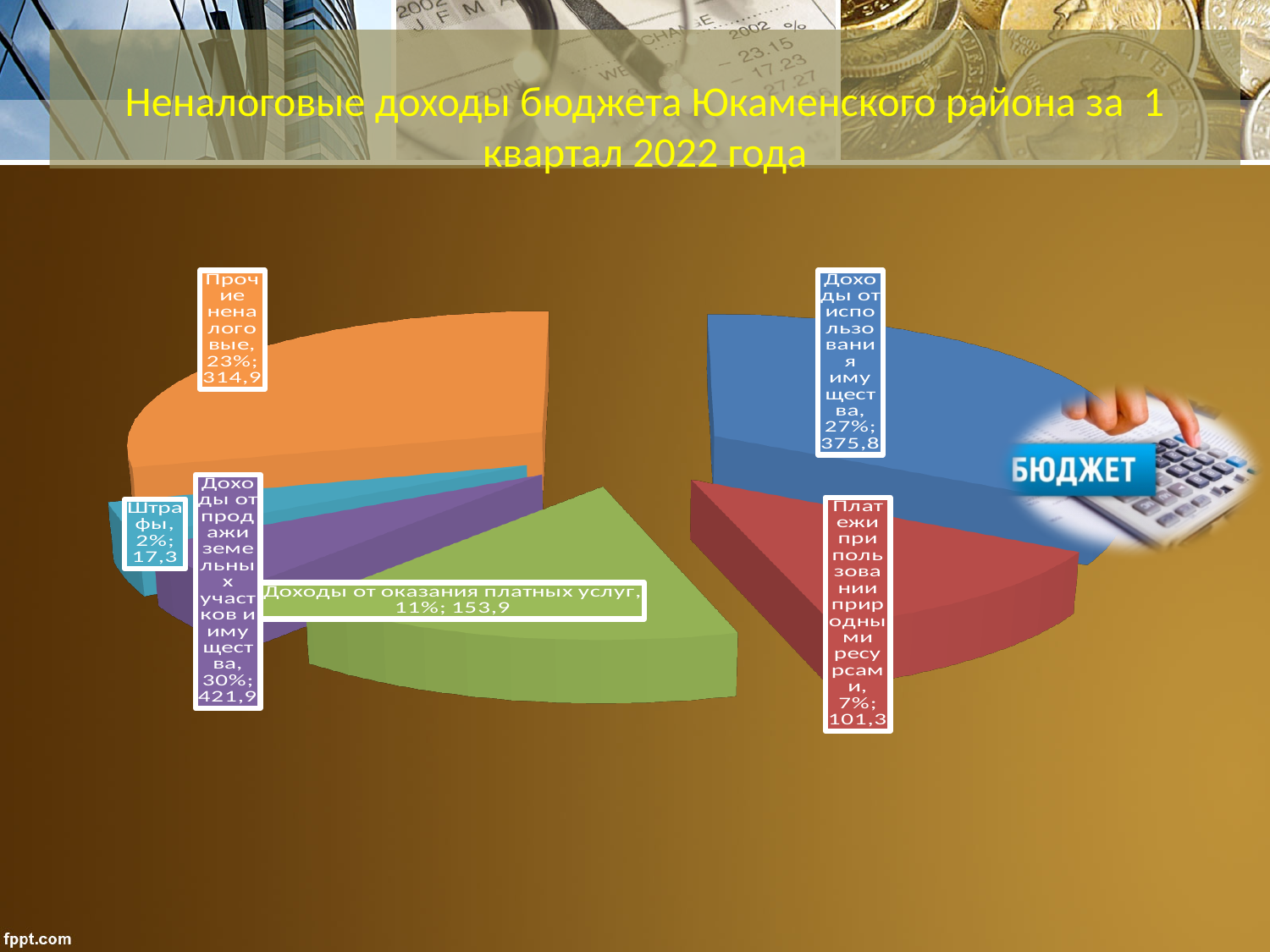
Какое значение указано для категории «Доходы от продажи земельных участков и имущества»? 421,9 На сколько значение «Прочие неналоговые» больше значения «Платежи при пользовании природными ресурсами»? 213,6 Какое значение указано для категории «Штрафы»? 17,3 Что больше: «Доходы от использования имущества» или «Прочие неналоговые»? Доходы от использования имущества Какая категория имеет наименьшую долю на диаграмме? Штрафы Какую долю составляют «Доходы от использования имущества»? 27% Какую долю составляют «Платежи при пользовании природными ресурсами»? 7% Какое значение указано для категории «Доходы от оказания платных услуг»? 153,9 Как называется диаграмма на слайде? Неналоговые доходы бюджета Юкаменского района за 1 квартал 2022 года Какой тип диаграммы показан на слайде? Круговая диаграмма Сколько категорий (секторов) показано на круговой диаграмме? 6 Какая категория имеет наибольшую долю на диаграмме? Доходы от продажи земельных участков и имущества